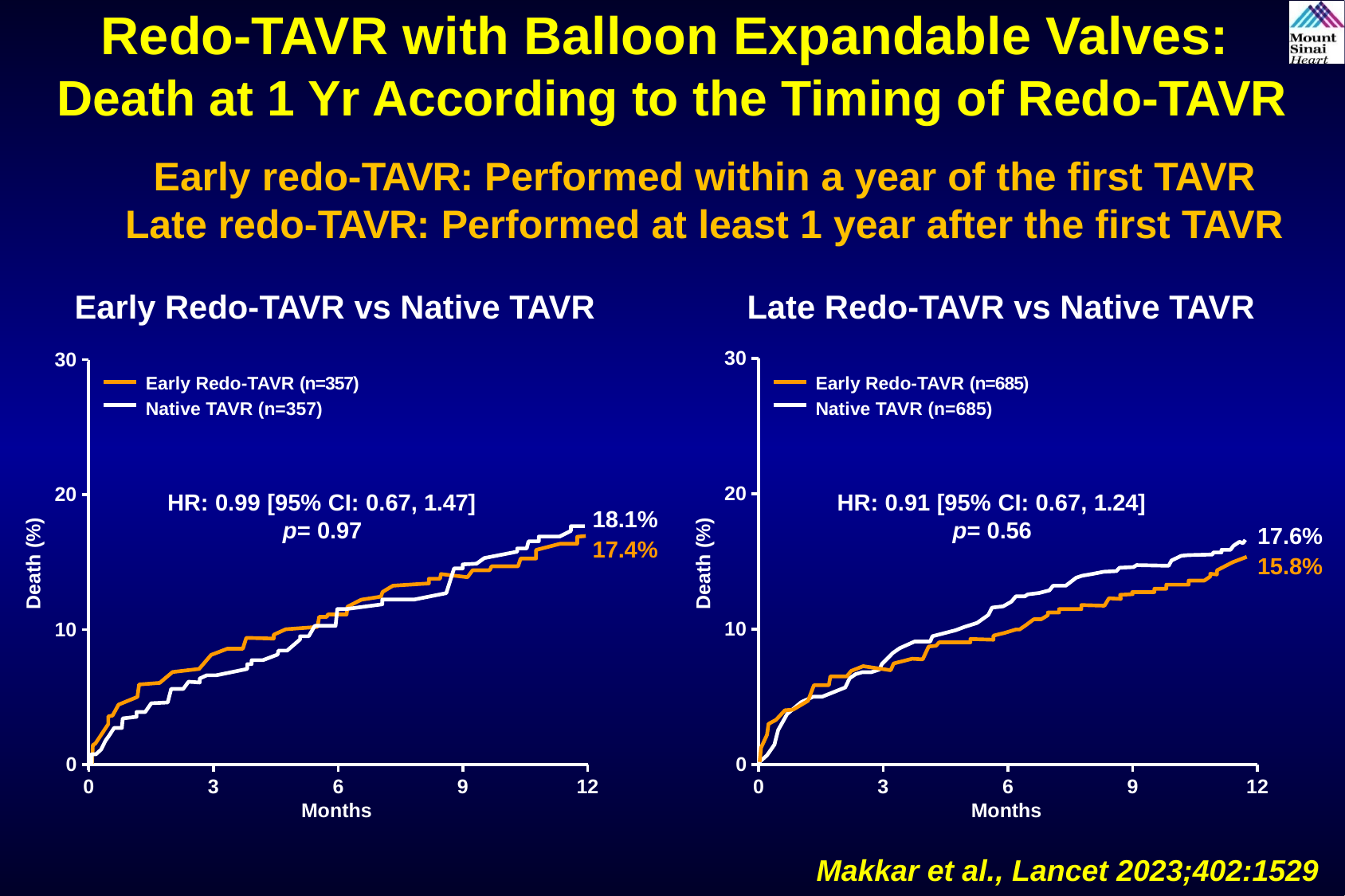
In the 'Early Redo-TAVR vs Native TAVR' chart, what is the 1-year death rate labelled for the Early Redo-TAVR curve? 17.4% In the 'Late Redo-TAVR vs Native TAVR' chart, what is the 1-year death rate labelled for the Native TAVR curve? 17.6% In the 'Early Redo-TAVR vs Native TAVR' chart, do the death curves rise or fall as months increase? Rise In the 'Late Redo-TAVR vs Native TAVR' chart, what is the difference in percentage points between the two labelled 1-year death rates? 1.8 In the 'Late Redo-TAVR vs Native TAVR' chart, which curve has the higher labelled death rate at 12 months? Native TAVR In the 'Late Redo-TAVR vs Native TAVR' chart, what is the 1-year death rate labelled for the orange redo-TAVR curve? 15.8% In the 'Early Redo-TAVR vs Native TAVR' chart, what is the 1-year death rate labelled for the Native TAVR curve? 18.1% In the 'Late Redo-TAVR vs Native TAVR' chart, is the Native TAVR death rate at 9 months greater or less than 10%? greater In the 'Early Redo-TAVR vs Native TAVR' chart, what is the difference in percentage points between the two labelled 1-year death rates? 0.7 What kind of chart is the 'Early Redo-TAVR vs Native TAVR' chart? Line chart How many series does the legend of the 'Late Redo-TAVR vs Native TAVR' chart list? 2 What hazard ratio is printed on the 'Late Redo-TAVR vs Native TAVR' chart? HR: 0.91 [95% CI: 0.67, 1.24]